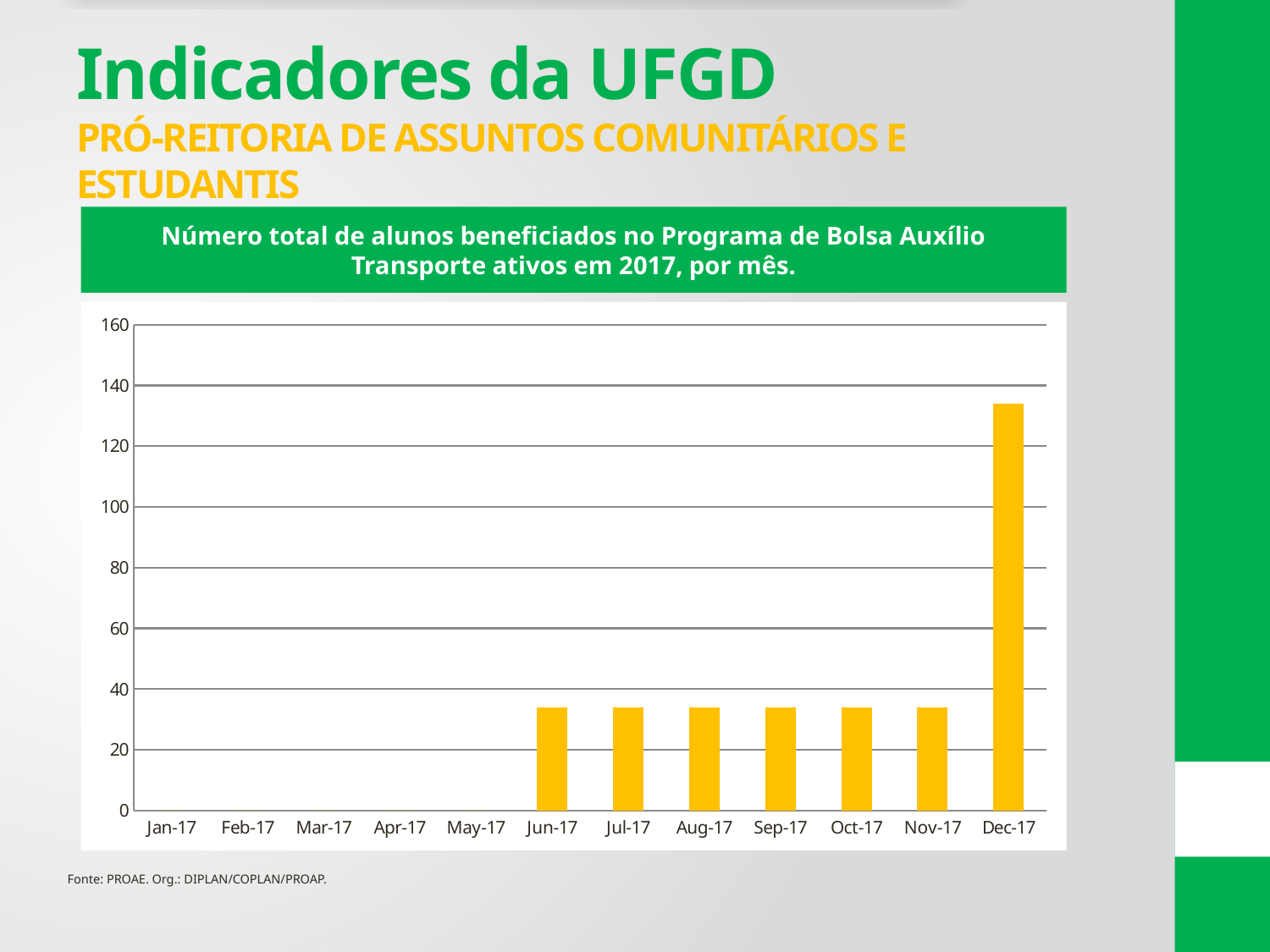
Is the value for Jun-17 greater or less than 40? less How many months are shown on the x axis of the chart? 12 Is the value for Dec-17 greater or less than 120? greater Which month has the highest value in the chart? Dec-17 Which is larger, the value for Nov-17 or the value for Dec-17? Dec-17 Does the value rise or fall from Nov-17 to Dec-17? rise Is the value for Sep-17 greater or less than 20? greater What colour are the bars in the chart? yellow How many months in the chart have a visible bar? 7 What kind of chart is shown on the slide? bar chart What is the first month on the x axis that shows a bar? Jun-17